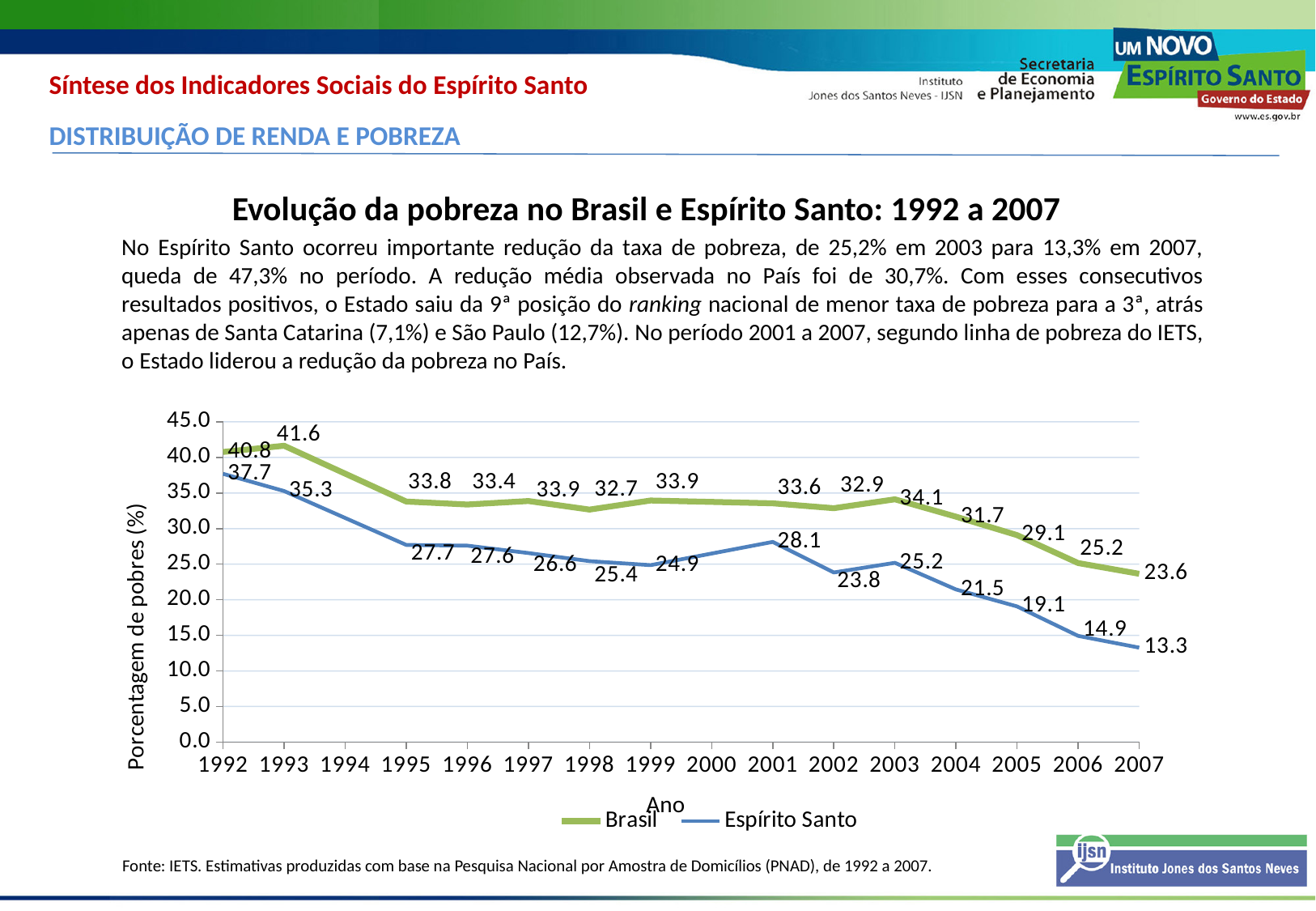
Which series has the higher value in 1999, Brasil or Espírito Santo? Brasil What is the label of the y axis? Porcentagem de pobres (%) How many series does the legend list? 2 Does the Espírito Santo series generally rise or fall from 1992 to 2007? fall In which year is the Brasil series at its highest? 1993 In which year is the Espírito Santo series at its lowest? 2007 What type of chart is shown on the slide? line chart What is the difference between the Brasil and Espírito Santo values in 2007? 10.3 What is the difference between the Espírito Santo values in 2003 and 2007? 11.9 What is the value for Espírito Santo in 2007? 13.3 What is the value for Brasil in 1993? 41.6 What is the value for Espírito Santo in 2001? 28.1